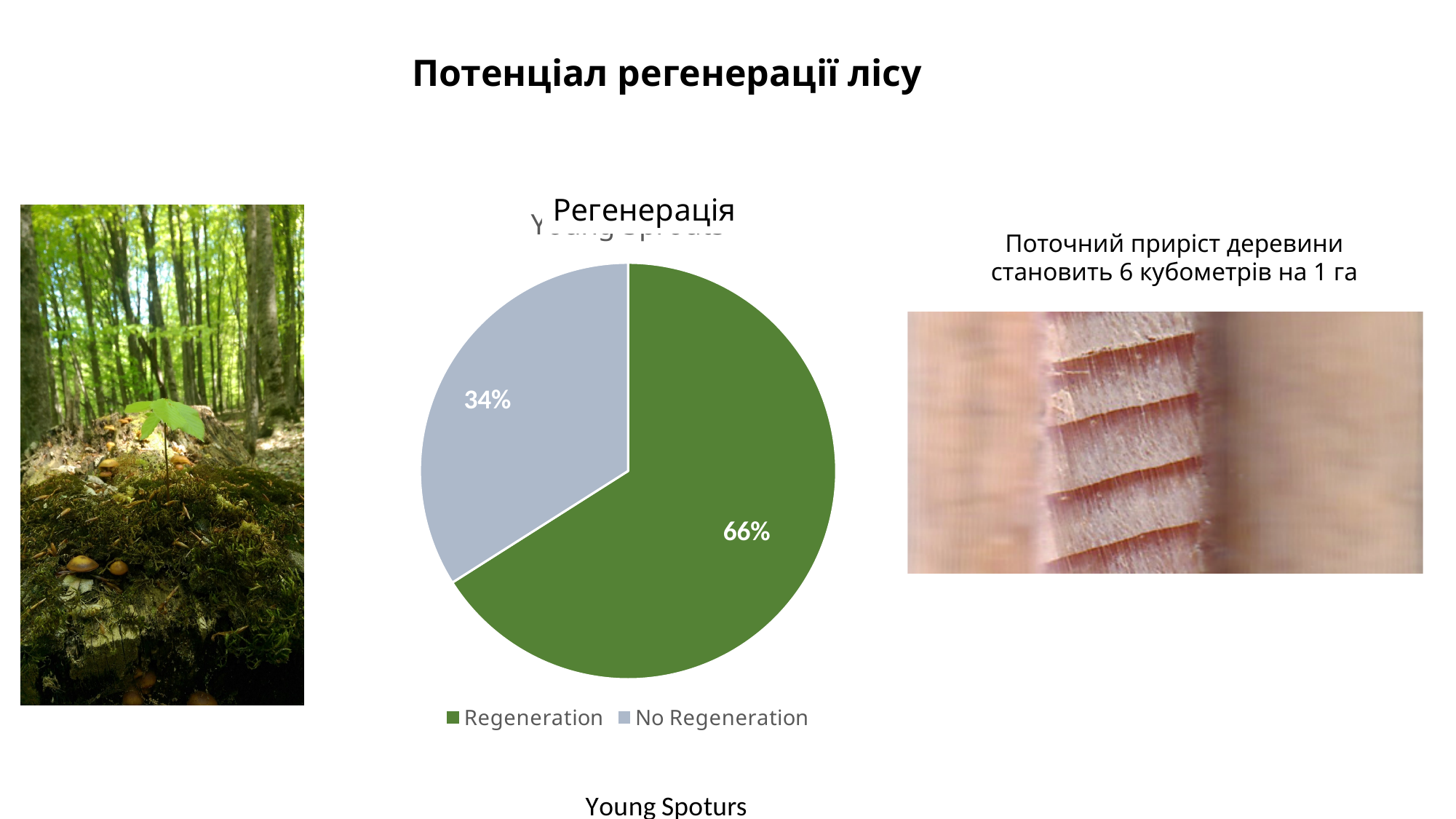
What colour is the Regeneration slice? Green What colour is the No Regeneration slice? Grey-blue Which is larger, the Regeneration slice or the No Regeneration slice? Regeneration What is the difference in percentage points between the Regeneration and No Regeneration slices? 32 What kind of chart is shown on the slide? Pie chart How many slices does the pie chart have? 2 Which slice of the pie is the smallest? No Regeneration What share of the pie does No Regeneration take? 34% What share of the pie does Regeneration take? 66% How many entries does the chart legend list? 2 Which slice of the pie is the largest? Regeneration